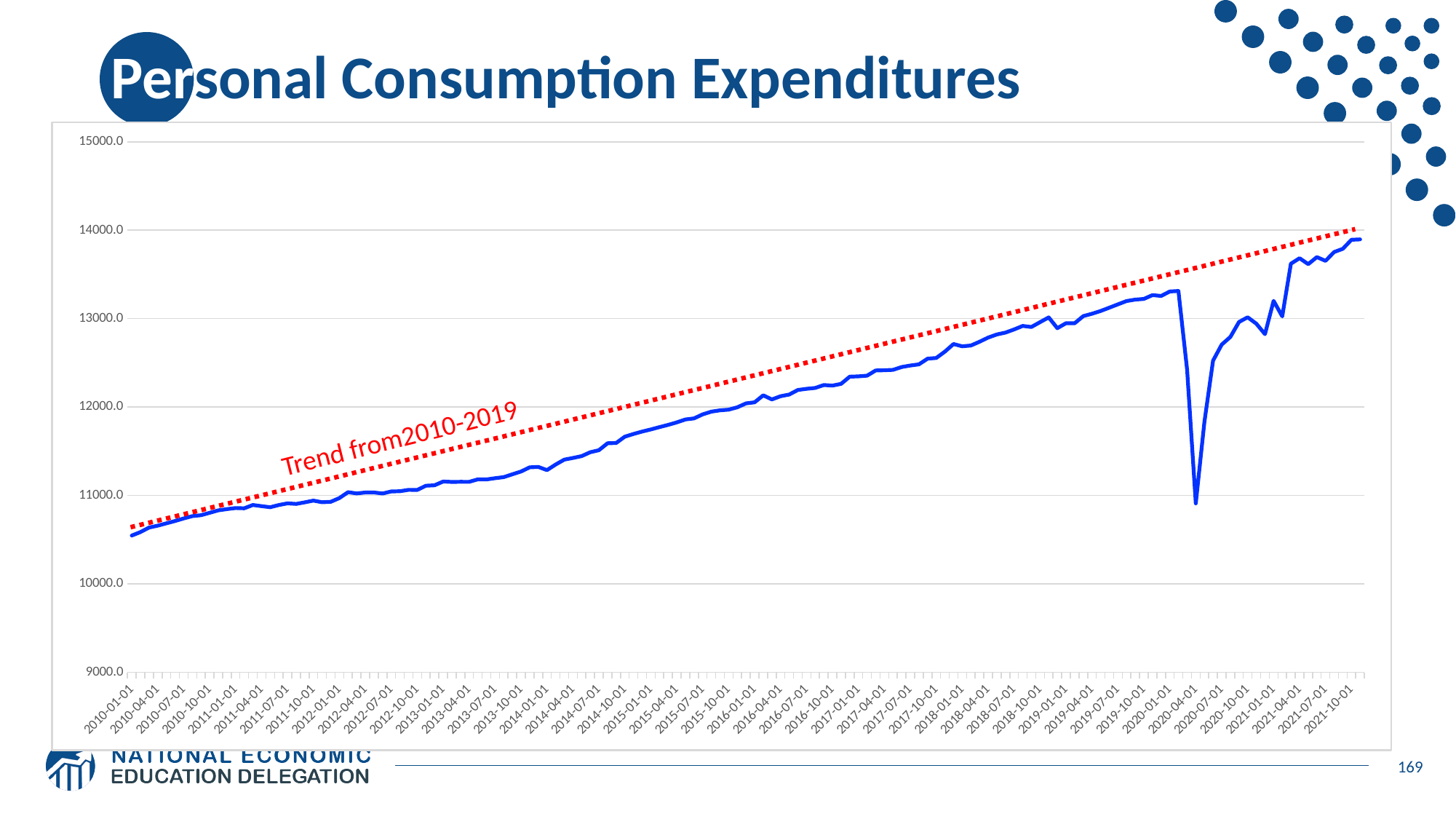
Is the value for 2021-10-01 greater or less than 14000? less What kind of chart is shown on the slide? line chart What is the highest tick value shown on the vertical axis? 15000.0 Is the value for 2015-01-01 greater or less than 11000? greater Is the value for 2010-01-01 greater or less than 11000? less What is the title of the slide's chart? Personal Consumption Expenditures Does the blue line rise or fall sharply between 2020-01-01 and 2020-04-01? fall What label is written along the red dotted line? Trend from2010-2019 Which is larger, the value for 2019-01-01 or the value for 2012-01-01? 2019-01-01 Overall, do the values of the blue line rise or fall from 2010-01-01 to 2021-10-01? rise